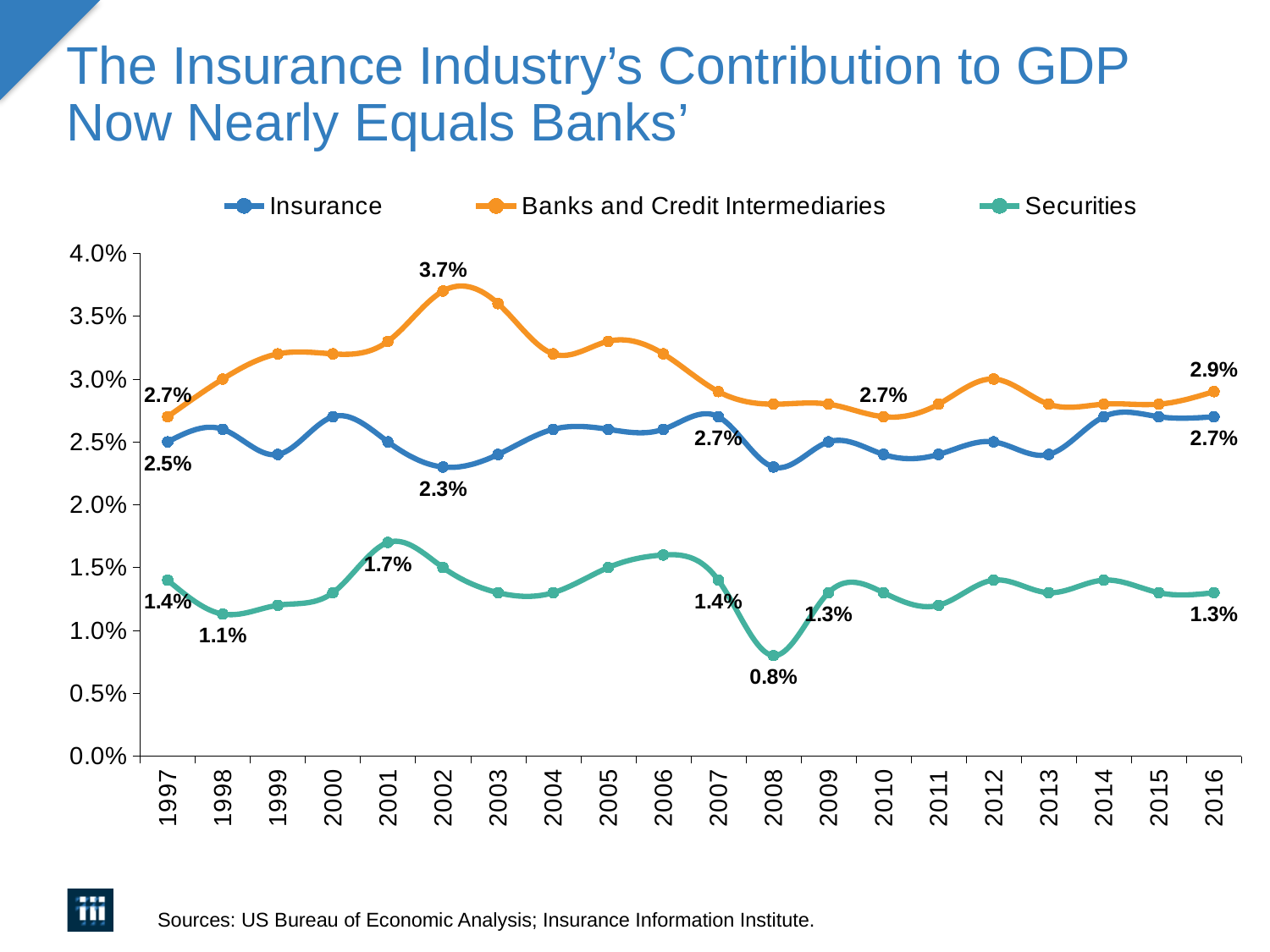
In 2016, how much higher was the Banks and Credit Intermediaries value than the Insurance value? 0.2 percentage points What was the Securities value in 2008? 0.8% What was the Insurance value in 2016? 2.7% In 1997, which was larger: Insurance or Banks and Credit Intermediaries? Banks and Credit Intermediaries Which series is shown in orange? Banks and Credit Intermediaries Is the Insurance value for 2008 greater or less than 2.5%? less What kind of chart is shown on the slide? Line chart In which year did Securities reach its lowest value? 2008 How many series does the legend list? 3 How many years are shown along the x axis? 20 In which year did Banks and Credit Intermediaries reach its highest value? 2002 What was the Banks and Credit Intermediaries value in 2002? 3.7%